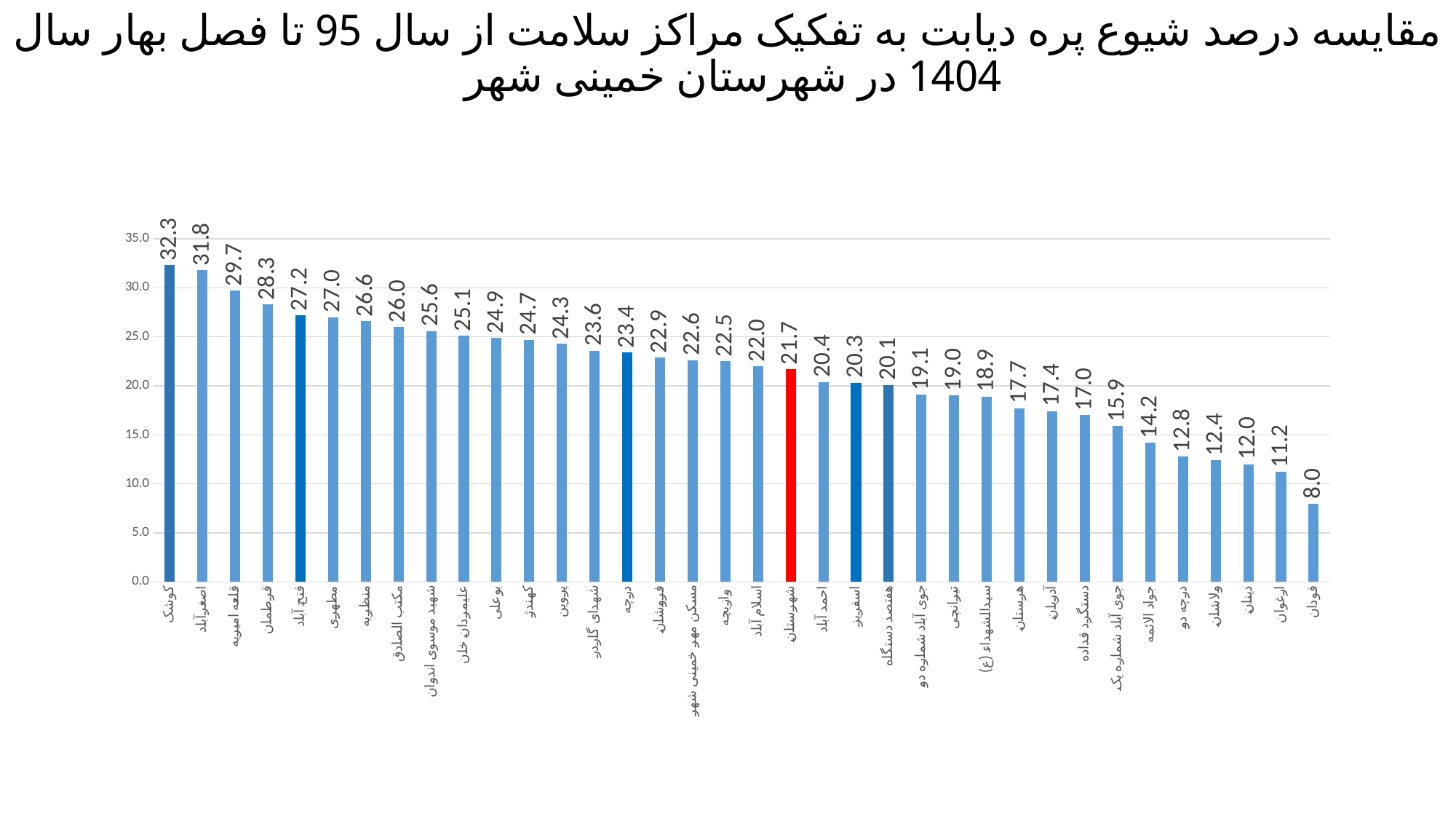
Which bar is coloured red? شهرستان What is the value for فودان? 8.0 What is the value for شهرستان (the red bar)? 21.7 Which category has the lowest value? فودان How many bars are plotted in the chart? 36 Which is larger, the value for درچه or the value for اسفریز? درچه Do the values rise or fall from left to right along the x axis? fall Is the value for هرستان greater or less than 20.0? less What is the difference between the values for کوشک and فودان? 24.3 What is the value for کوشک? 32.3 Which category has the highest value? کوشک What kind of chart is shown on the slide? bar chart